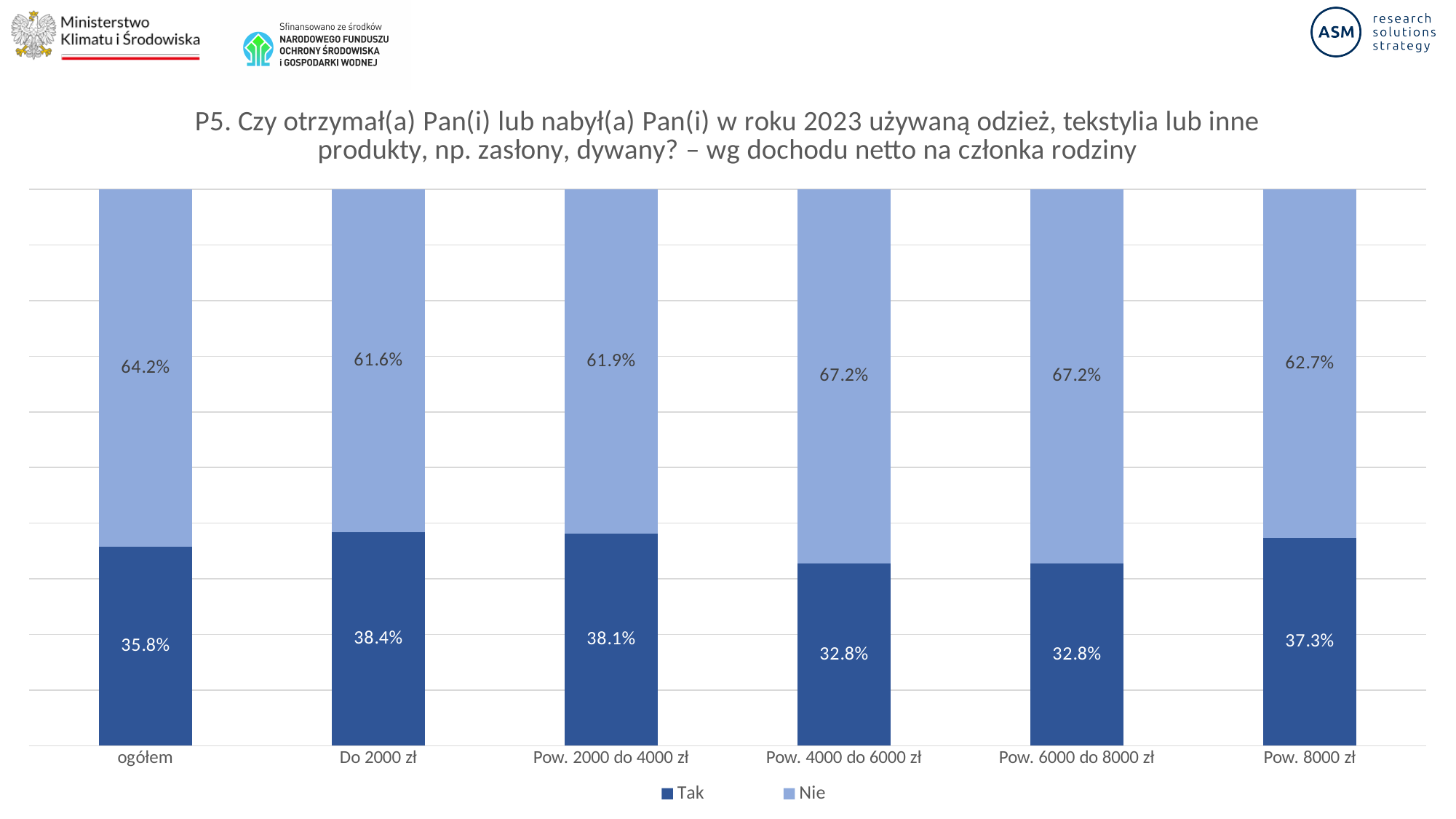
What is the total of the stacked bar for the 'Do 2000 zł' category? 100% What is the difference between the 'Nie' and 'Tak' values for the 'ogółem' category? 28.4 percentage points What is the 'Tak' value for the 'Pow. 2000 do 4000 zł' category? 38.1% Which is larger: the 'Tak' value for 'Pow. 8000 zł' or the 'Tak' value for 'Pow. 6000 do 8000 zł'? Pow. 8000 zł What percentage of respondents in the 'ogółem' category answered 'Tak'? 35.8% How many income categories are shown on the x axis? 6 Which category has the lowest 'Nie' value? Do 2000 zł Which category has the highest 'Tak' value? Do 2000 zł What kind of chart is shown on the slide? Stacked bar chart How many series does the legend list? 2 What is the 'Nie' value for the 'Pow. 4000 do 6000 zł' category? 67.2% What is the 'Nie' value for the 'Pow. 8000 zł' category? 62.7%